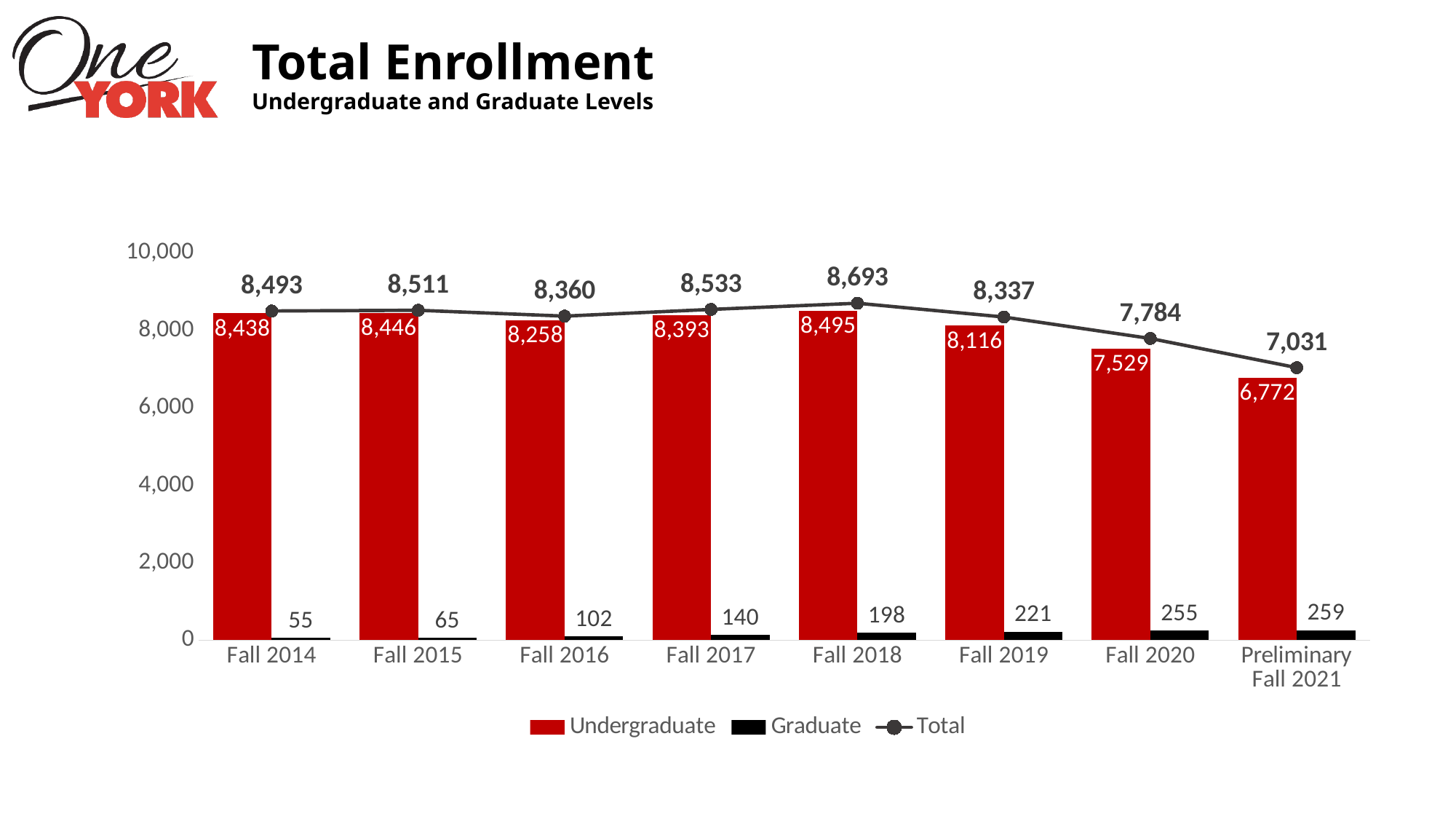
What is the difference between the Undergraduate enrollment in Fall 2020 and Preliminary Fall 2021? 757 What is the Total enrollment for Preliminary Fall 2021? 7,031 What is the Undergraduate enrollment for Fall 2018? 8,495 What is the Graduate enrollment for Fall 2020? 255 Does the Graduate enrollment rise or fall from Fall 2014 to Preliminary Fall 2021? Rise Which is larger, the Graduate enrollment in Fall 2017 or in Fall 2019? Fall 2019 How many series does the legend list? 3 Which term has the highest Total enrollment? Fall 2018 How many terms are shown on the x axis? 8 Which term has the lowest Graduate enrollment? Fall 2014 What kind of chart is used for the Undergraduate and Graduate series? Bar chart Is the Undergraduate enrollment for Fall 2019 greater or less than 8,000? greater